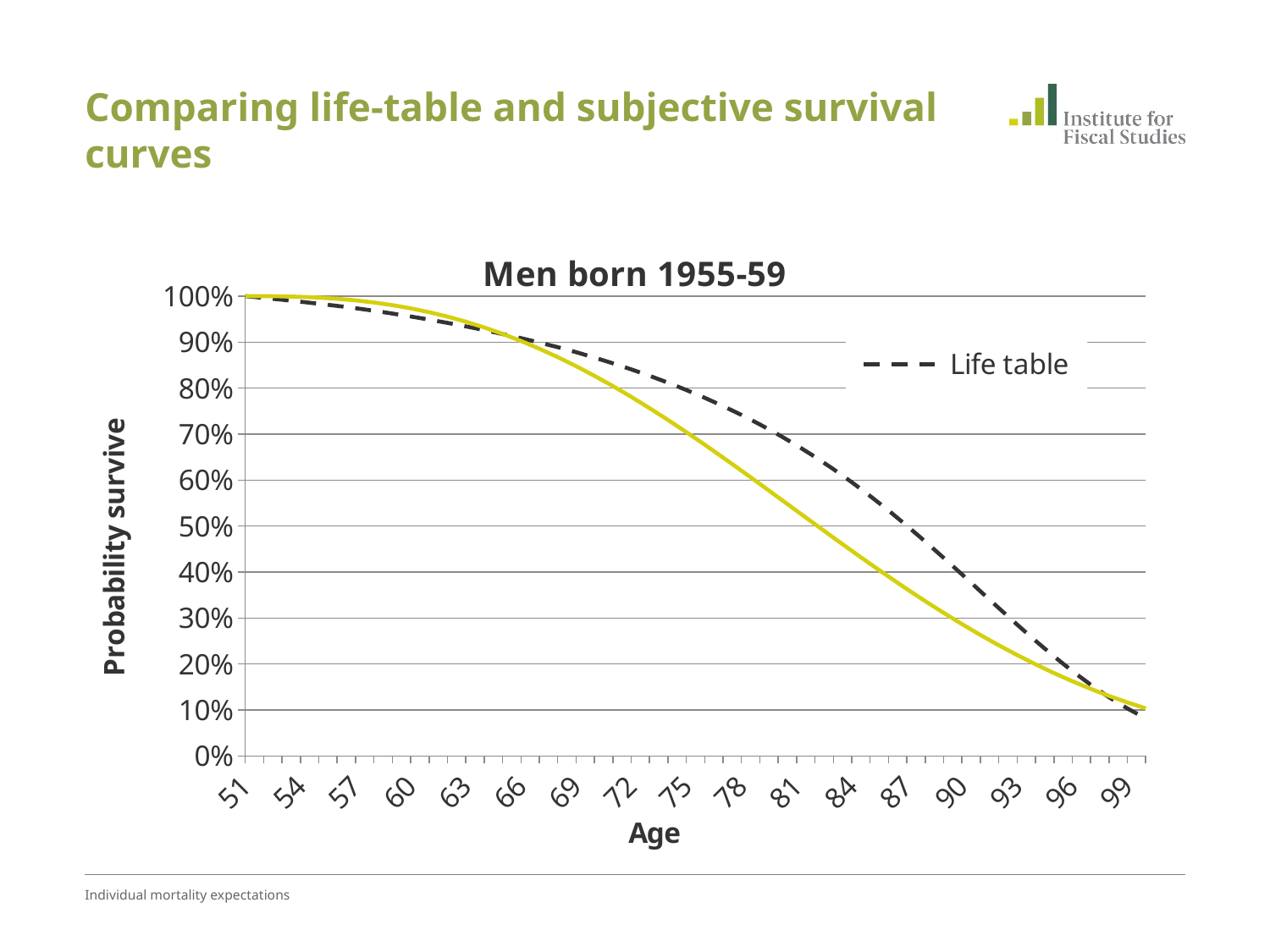
Is the Life table value at age 72 greater or less than 80%? greater Is the Life table value at age 60 greater or less than 90%? greater What is the title of the chart? Men born 1955-59 How many series does the chart's legend list? 1 Is the Life table value at age 78 greater or less than 70%? greater At age 84, which line is higher: the dashed Life table line or the solid line? Life table How many age labels are shown on the x axis? 17 What kind of chart is shown on the slide? Line chart What is the label of the series shown in the legend? Life table Does the Life table line rise or fall as age increases? Fall